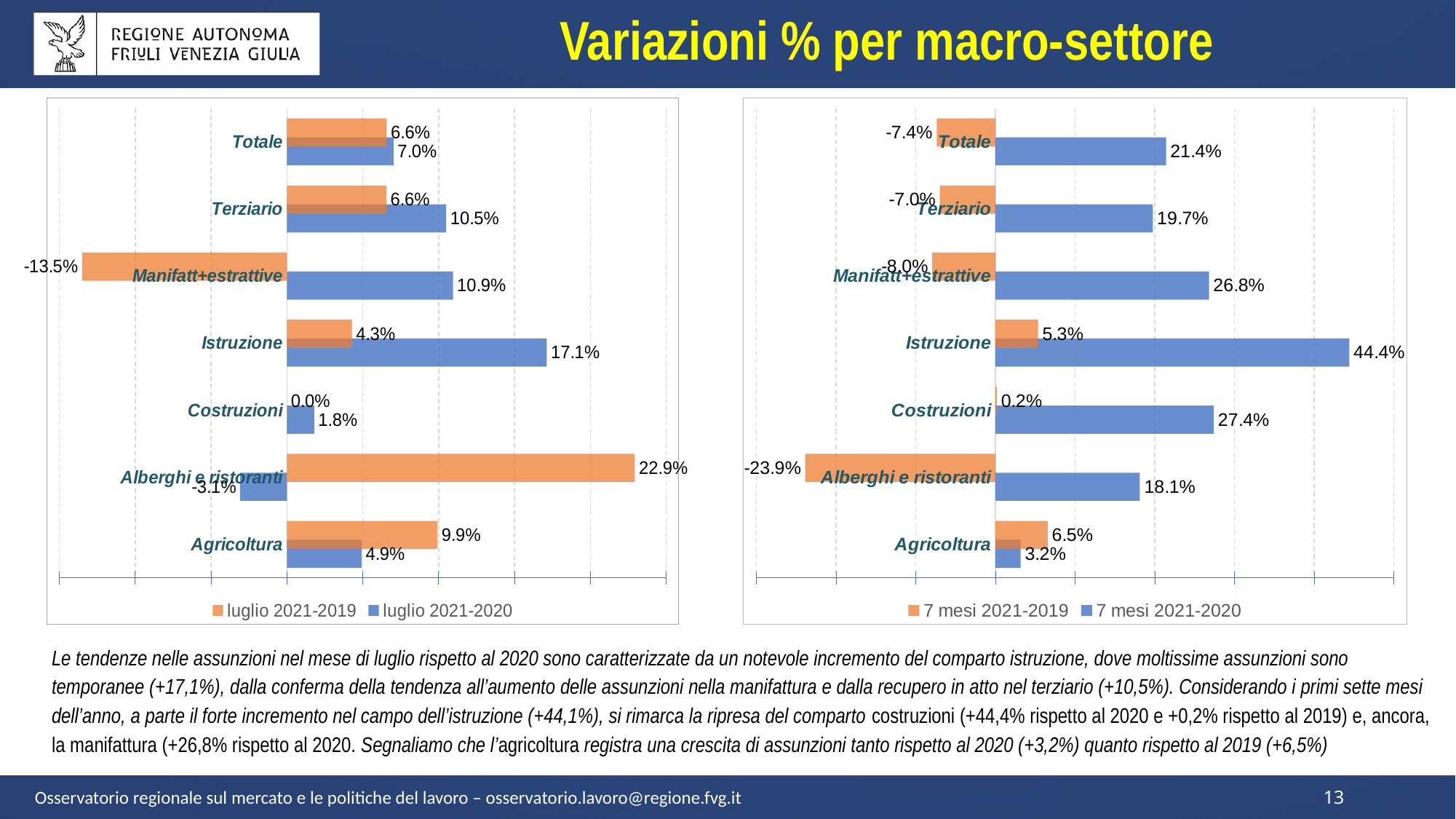
In the right chart, what is the value for Istruzione in the 7 mesi 2021-2020 series? 44.4% In the left chart, what is the value for Manifatt+estrattive in the luglio 2021-2019 series? -13.5% In the right chart, what is the value for Alberghi e ristoranti in the 7 mesi 2021-2019 series? -23.9% In the left chart, which category has the lowest value in the luglio 2021-2020 series? Alberghi e ristoranti In the right chart, which category has the highest value in the 7 mesi 2021-2020 series? Istruzione How many series does the legend of the left chart list? 2 How many categories are shown in the right chart? 7 In the left chart, which category has the highest value in the luglio 2021-2019 series? Alberghi e ristoranti In the left chart, what is the value for Istruzione in the luglio 2021-2020 series? 17.1% In the right chart, which is larger for Agricoltura: the 7 mesi 2021-2019 value or the 7 mesi 2021-2020 value? 7 mesi 2021-2019 In the left chart, what is the difference between the luglio 2021-2020 and luglio 2021-2019 values for Terziario? 3.9% What type of chart is the left chart? Bar chart